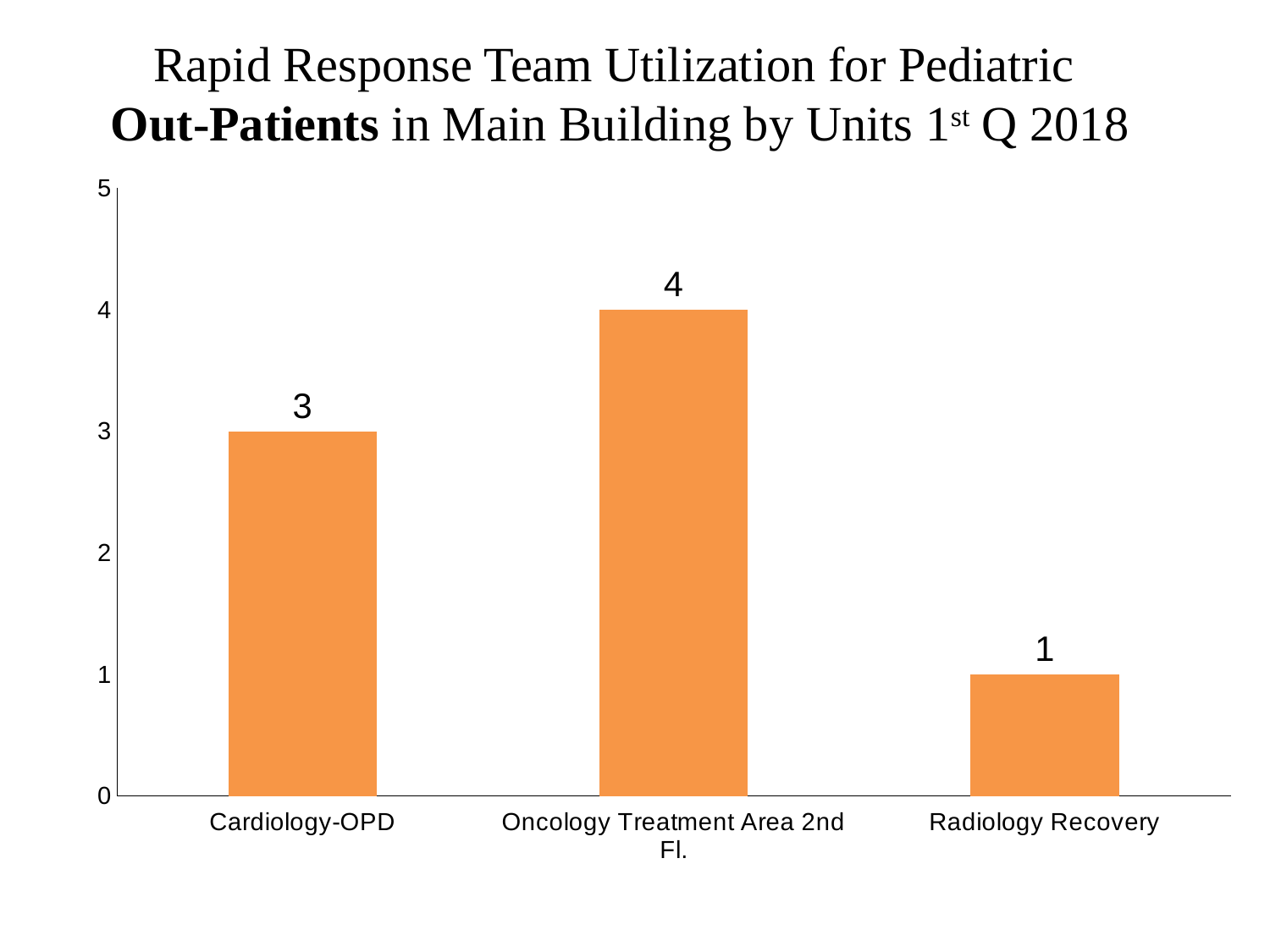
Which unit has the highest value? Oncology Treatment Area 2nd Fl. Is the value for Cardiology-OPD greater or less than 2? greater What is the difference between the values for Oncology Treatment Area 2nd Fl. and Radiology Recovery? 3 What kind of chart is shown on the slide? bar chart What is the value for Radiology Recovery? 1 What is the value for Oncology Treatment Area 2nd Fl.? 4 What is the title of the chart? Rapid Response Team Utilization for Pediatric Out-Patients in Main Building by Units 1st Q 2018 How many units are shown on the chart? 3 What is the value for Cardiology-OPD? 3 What is the difference between the values for Cardiology-OPD and Radiology Recovery? 2 Which is larger, the value for Cardiology-OPD or the value for Oncology Treatment Area 2nd Fl.? Oncology Treatment Area 2nd Fl. Which unit has the lowest value? Radiology Recovery